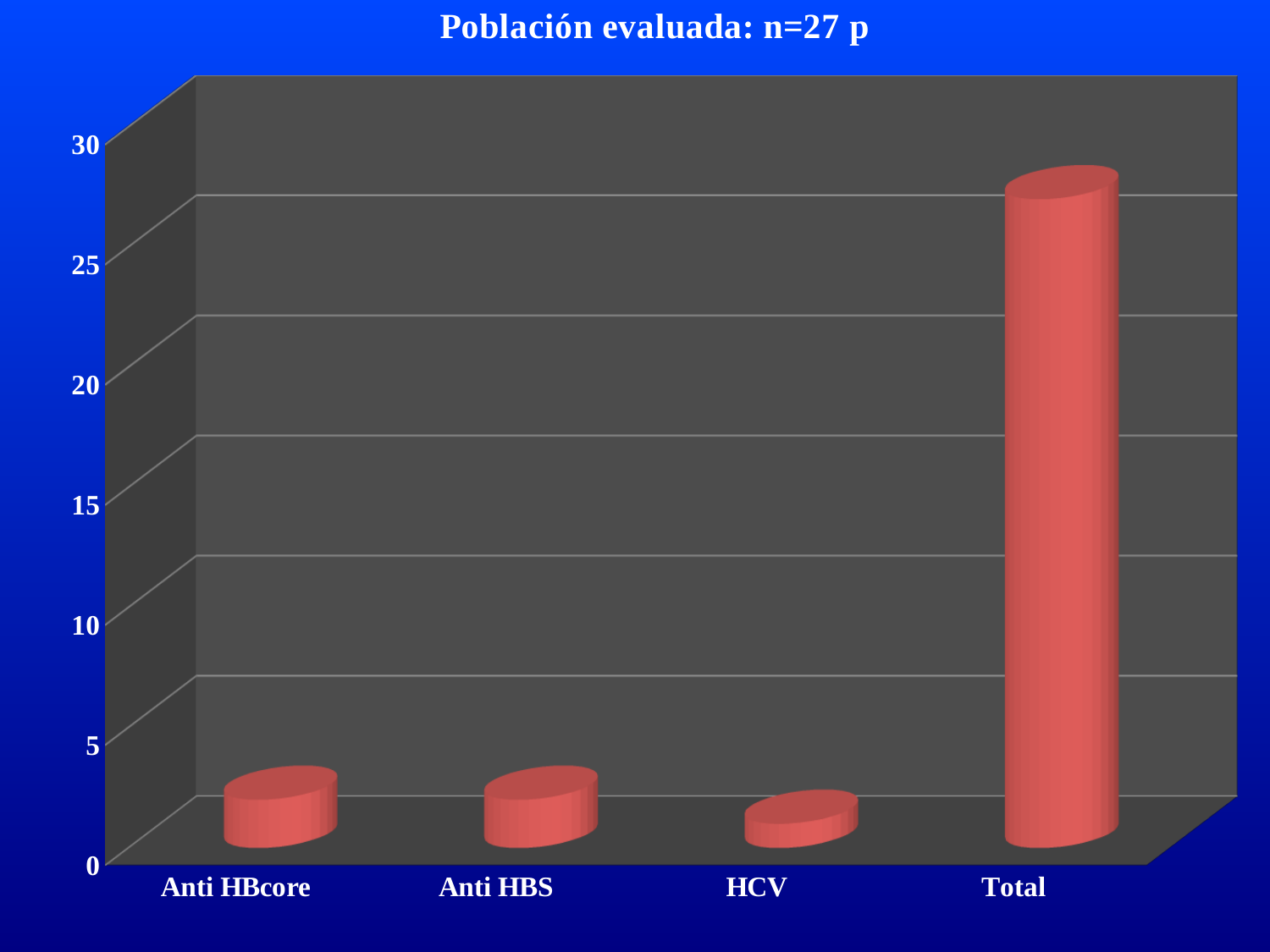
How many categories are shown on the x axis of the chart? 4 What colour are the bars in the chart? red Is the value for Anti HBcore greater or less than 5? less What kind of chart is shown on the slide? bar chart Which is larger, the value for Anti HBS or the value for HCV? Anti HBS Which category has the highest bar? Total Is the value for Total greater or less than 25? greater Which category has the lowest bar? HCV What is the title of the chart? Población evaluada: n=27 p Is the value for HCV greater or less than 5? less Which is larger, the value for Total or the value for HCV? Total